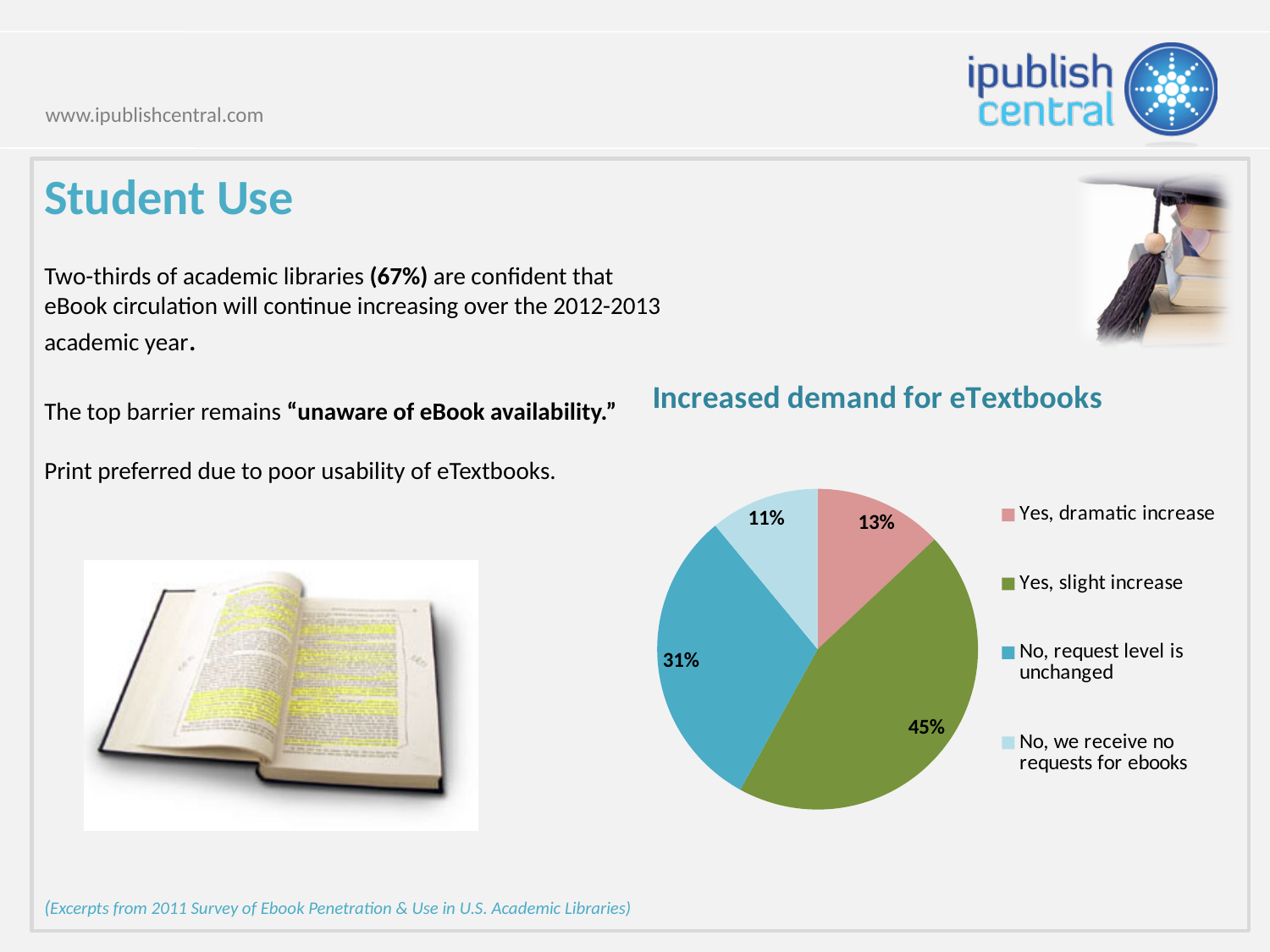
Which category has the largest share of the pie? Yes, slight increase What colour is the 'No, request level is unchanged' slice? Blue What percentage of the pie is 'No, request level is unchanged'? 31% What percentage of the pie is 'Yes, slight increase'? 45% What is the title of the chart? Increased demand for eTextbooks What is the difference between the shares for 'Yes, slight increase' and 'No, request level is unchanged'? 14% Which is larger: the share for 'Yes, dramatic increase' or 'No, we receive no requests for ebooks'? Yes, dramatic increase What percentage of the pie is 'No, we receive no requests for ebooks'? 11% What kind of chart is shown on the slide? Pie chart Which category has the smallest share of the pie? No, we receive no requests for ebooks How many categories does the legend list? 4 What percentage of the pie is 'Yes, dramatic increase'? 13%